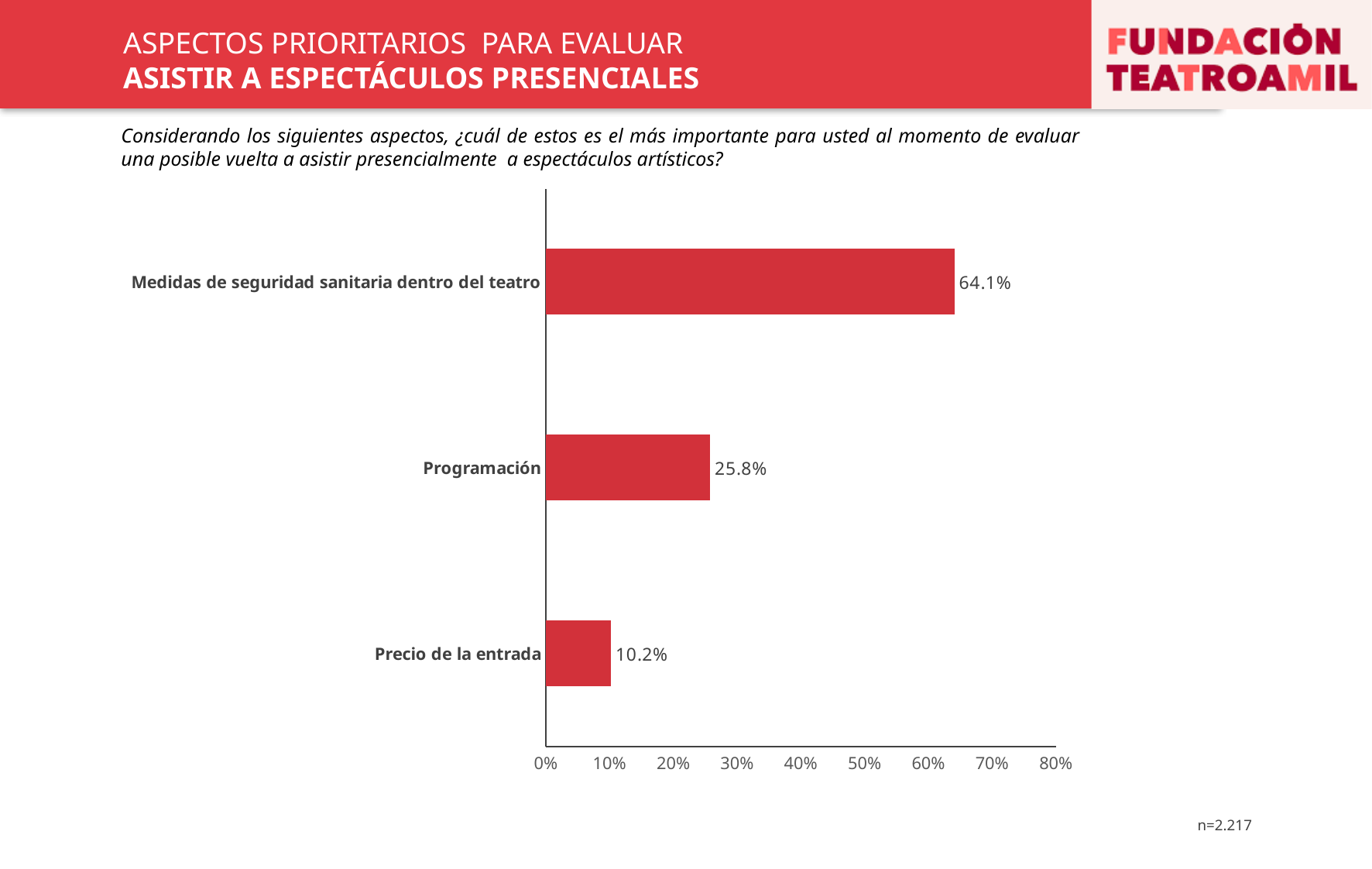
What is the difference between the values for Medidas de seguridad sanitaria dentro del teatro and Programación? 38.3% What is the maximum value shown on the horizontal axis? 80% What is the difference between the values for Programación and Precio de la entrada? 15.6% Which category has the highest value? Medidas de seguridad sanitaria dentro del teatro Which is larger, the value for Programación or the value for Precio de la entrada? Programación What is the value for Programación? 25.8% What kind of chart is shown on the slide? bar chart What is the value for Medidas de seguridad sanitaria dentro del teatro? 64.1% Is the value for Medidas de seguridad sanitaria dentro del teatro greater or less than 50%? greater Which category has the lowest value? Precio de la entrada How many categories are shown in the chart? 3 What is the value for Precio de la entrada? 10.2%